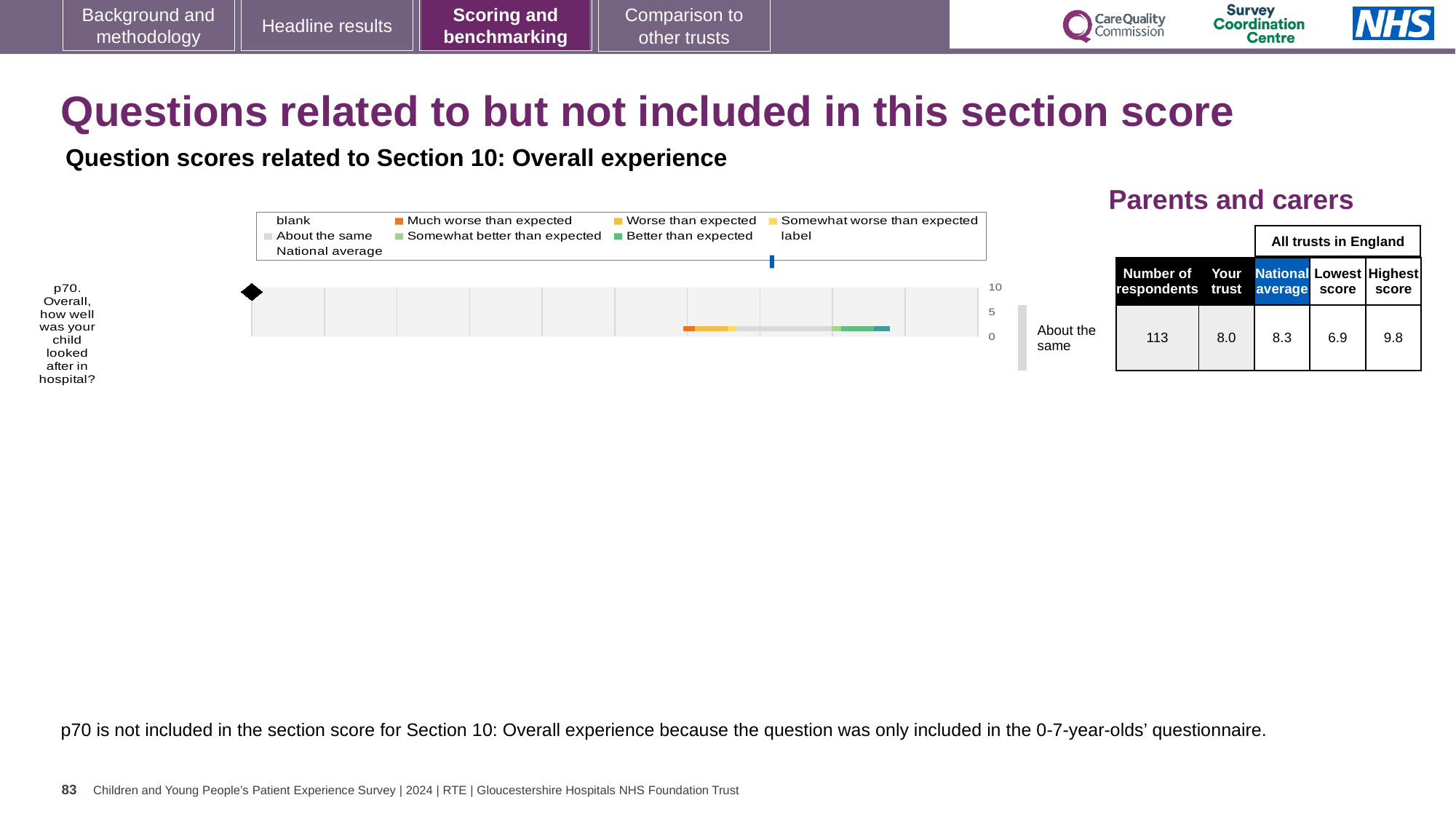
What category label is shown to the right of the p70 bar? About the same What is the lowest score among all trusts in England for p70? 6.9 What is the difference between the national average and the trust's score for p70? 0.3 Which is larger for p70, the trust's score or the national average? National average How many questions are plotted in the chart? 1 How many respondents answered p70? 113 What kind of chart is shown for question p70? bar chart What is the maximum value shown on the chart's score axis? 10 What is the difference between the highest and lowest trust scores for p70? 2.9 What is the 'Your trust' score for p70 shown in the table next to the chart? 8.0 What is the highest score among all trusts in England for p70? 9.8 What is the national average score for p70? 8.3